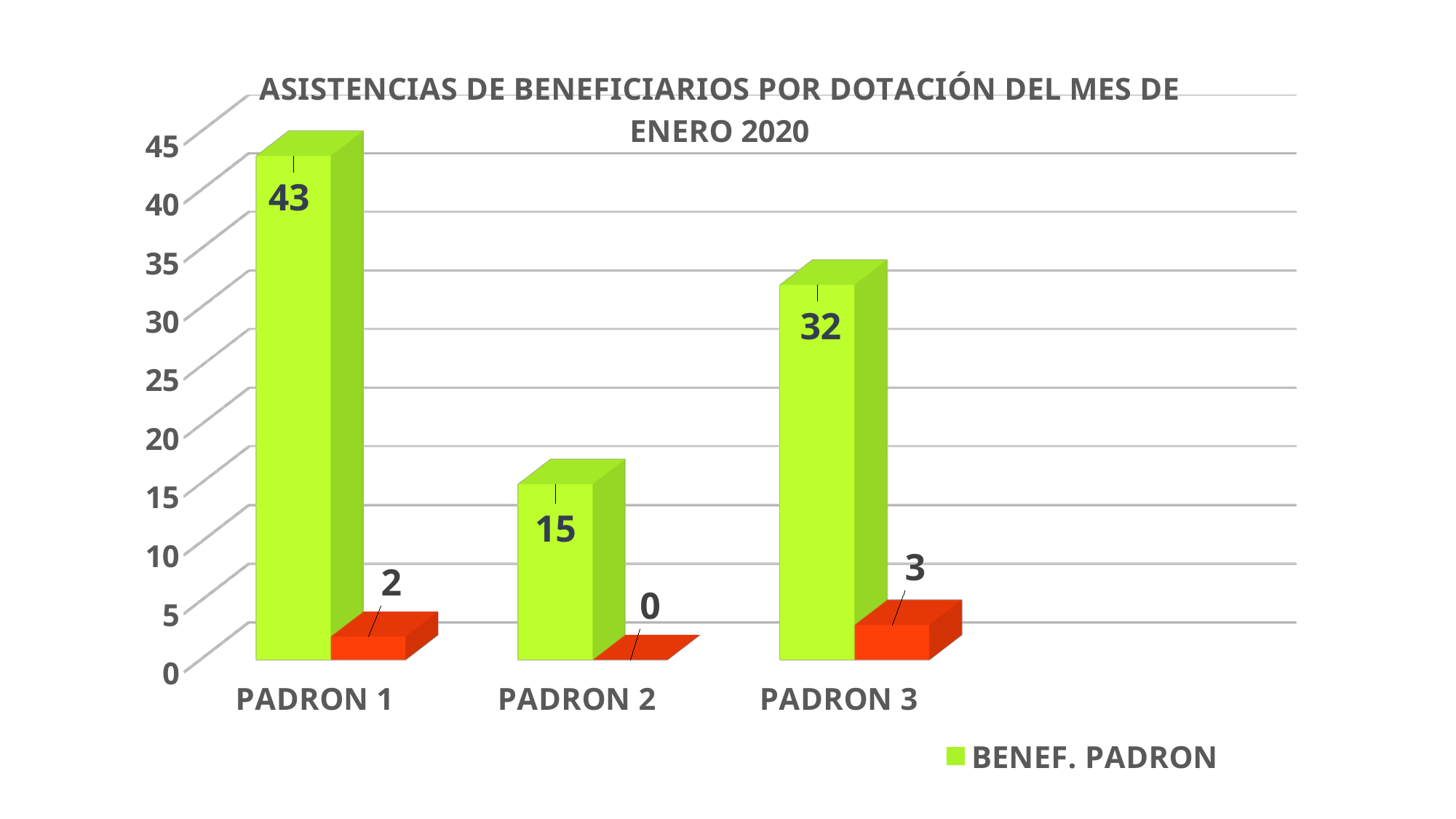
Which category has the highest BENEF. PADRON value? PADRON 1 What type of chart is shown on the slide? Bar chart Which category has the lowest BENEF. PADRON value? PADRON 2 What is the BENEF. PADRON value for PADRON 1? 43 What is the BENEF. PADRON value for PADRON 3? 32 How many series does the legend list? 1 Which has a larger BENEF. PADRON value, PADRON 2 or PADRON 3? PADRON 3 What is the difference between the BENEF. PADRON values for PADRON 1 and PADRON 3? 11 What value is shown on the orange bar for PADRON 2? 0 How many categories are shown on the x axis? 3 What is the BENEF. PADRON value for PADRON 2? 15 What value is shown on the orange bar for PADRON 3? 3